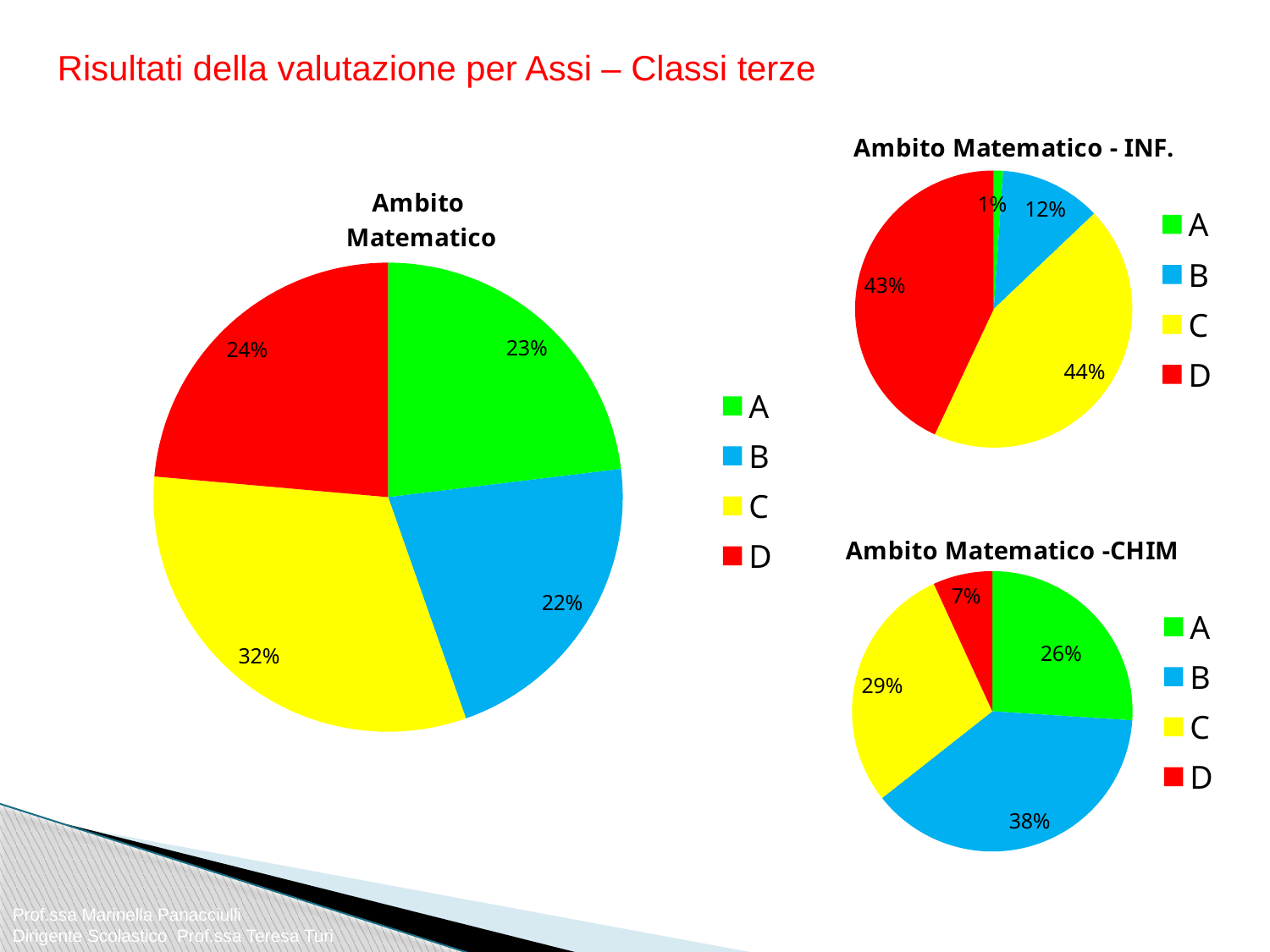
In the 'Ambito Matematico - INF.' pie chart, which category has the smallest share? A How many entries does the legend of the 'Ambito Matematico' chart list? 4 In the 'Ambito Matematico -CHIM' pie chart, which is larger, the share for A or the share for C? C In the 'Ambito Matematico -CHIM' pie chart, which category has the largest share? B In the 'Ambito Matematico' pie chart, what is the difference between the shares of C and B? 10% In the 'Ambito Matematico - INF.' pie chart, what is the share for B? 12% In the 'Ambito Matematico' pie chart, which category has the largest share? C In the 'Ambito Matematico -CHIM' pie chart, what is the share for D? 7% How many slices does the 'Ambito Matematico -CHIM' pie chart have? 4 What type of chart is 'Ambito Matematico - INF.'? Pie chart In the 'Ambito Matematico - INF.' pie chart, what is the difference between the shares of D and B? 31% In the 'Ambito Matematico' pie chart, what is the share for C? 32%